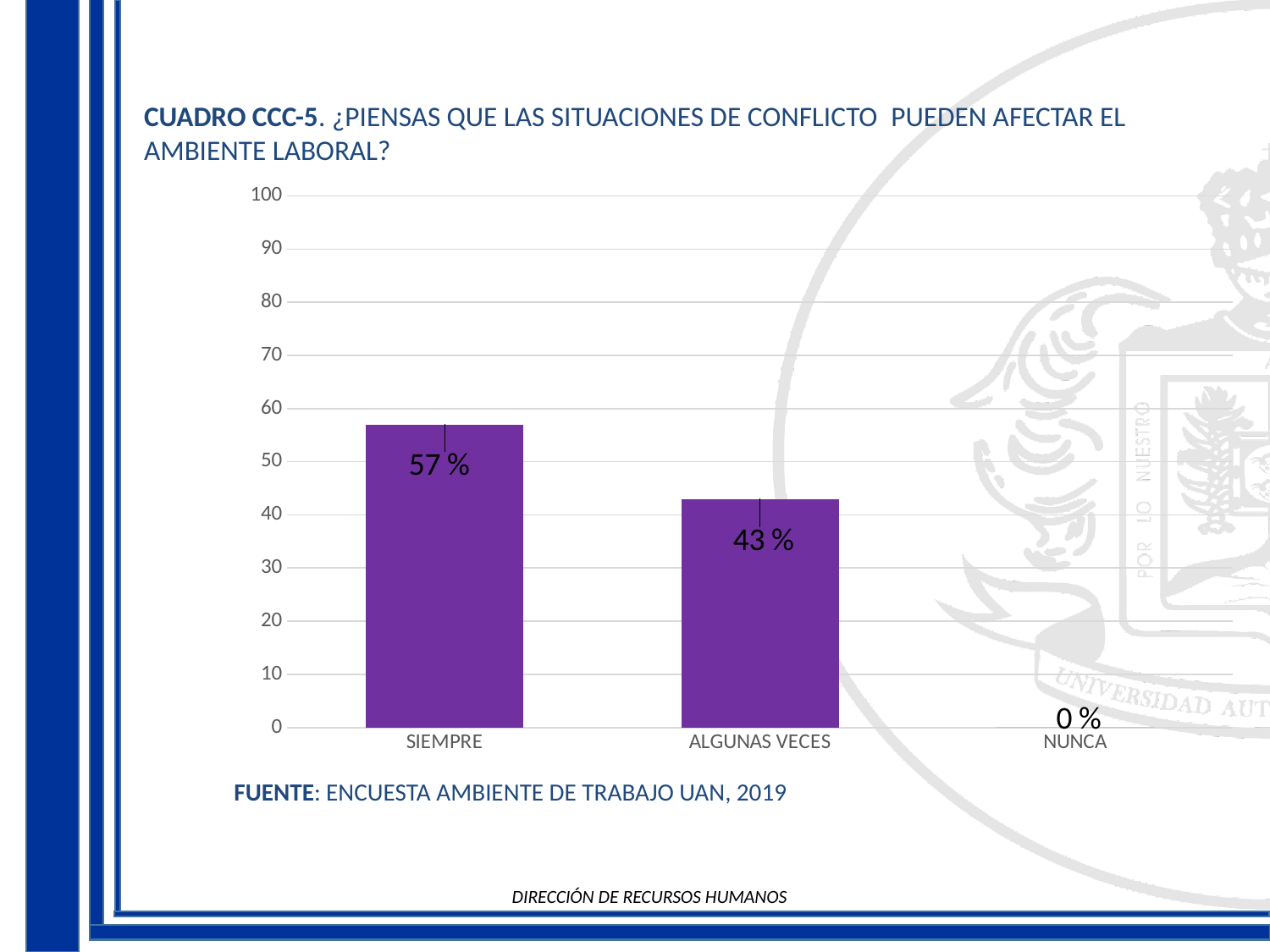
Which category has the highest value? SIEMPRE Which category has the lowest value? NUNCA Is the value for ALGUNAS VECES greater or less than 50? less What is the difference between the values for SIEMPRE and ALGUNAS VECES? 14 % What is the value for SIEMPRE? 57 % What is the value for ALGUNAS VECES? 43 % What is the source cited below the chart? ENCUESTA AMBIENTE DE TRABAJO UAN, 2019 What kind of chart is shown on the slide? bar chart Which is larger, the value for SIEMPRE or the value for ALGUNAS VECES? SIEMPRE Is the value for SIEMPRE greater or less than 50? greater What is the value for NUNCA? 0 % How many categories are shown on the x axis? 3